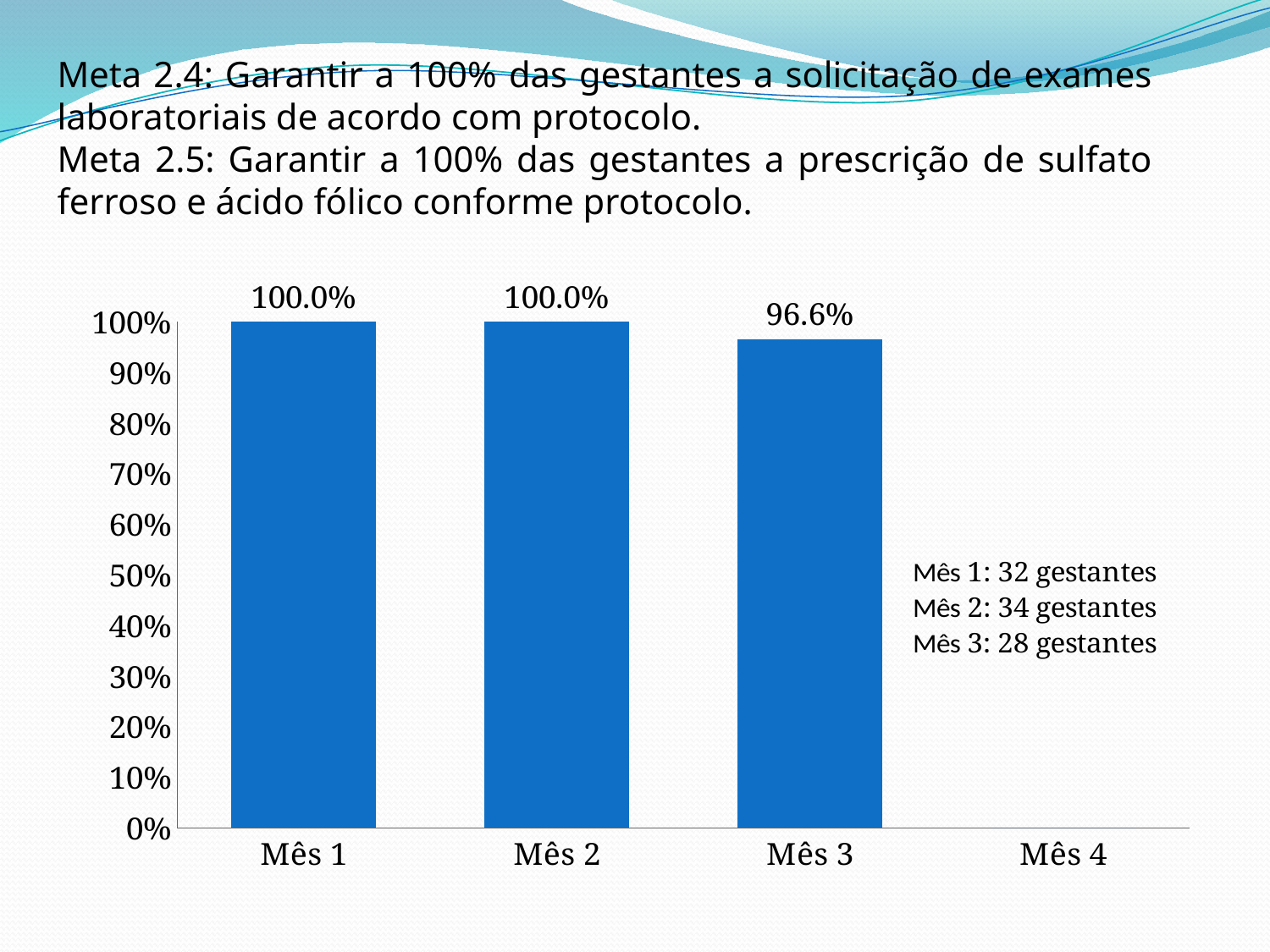
What is the value for Mês 3? 96.6% Is the value for Mês 3 greater or less than 90%? greater What is the value for Mês 1? 100.0% Which month has the lowest value among the plotted bars? Mês 3 What kind of chart is shown on the slide? bar chart According to the text beside the chart, how many gestantes were there in Mês 2? 34 gestantes Which is larger, the value for Mês 2 or the value for Mês 3? Mês 2 How many bars are plotted on the chart? 3 What is the difference between the values for Mês 1 and Mês 3? 3.4% What is the value for Mês 2? 100.0% Do the values rise or fall from Mês 2 to Mês 3? fall How many categories are labelled on the x axis? 4